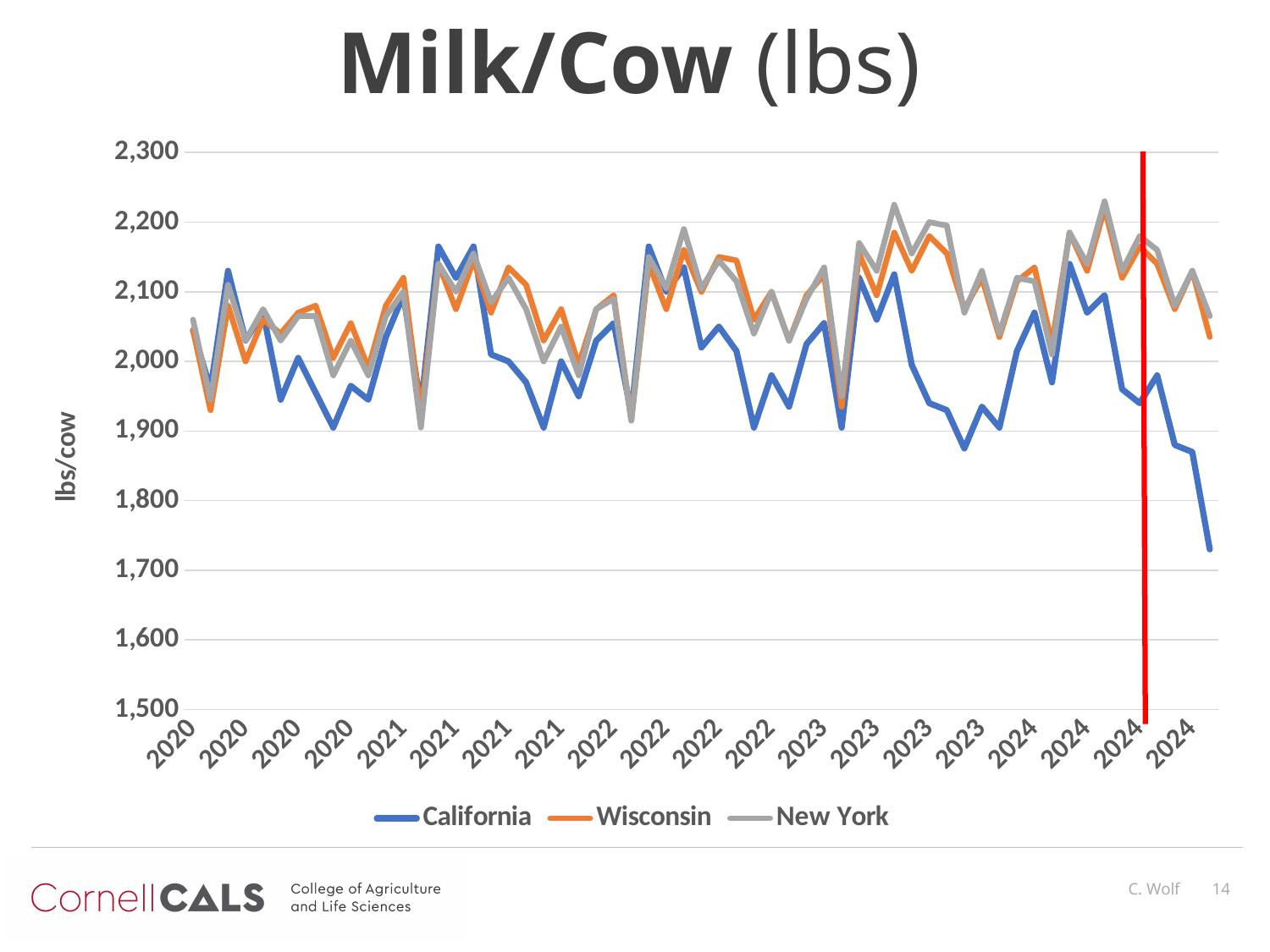
How many year labels are shown along the x axis? 20 What is the title of the chart? Milk/Cow (lbs) What kind of chart is shown on the slide? line chart Which series is generally the lowest across the chart? California What is the label on the vertical axis? lbs/cow Is the highest value for California greater or less than 2,200? less Is the highest value for New York greater or less than 2,200? greater Does the California line rise or fall over the last few points of 2024? fall At the final point on the right of the chart, which is higher, California or Wisconsin? Wisconsin Is the final value for California greater or less than 1,800? less How many series does the legend list? 3